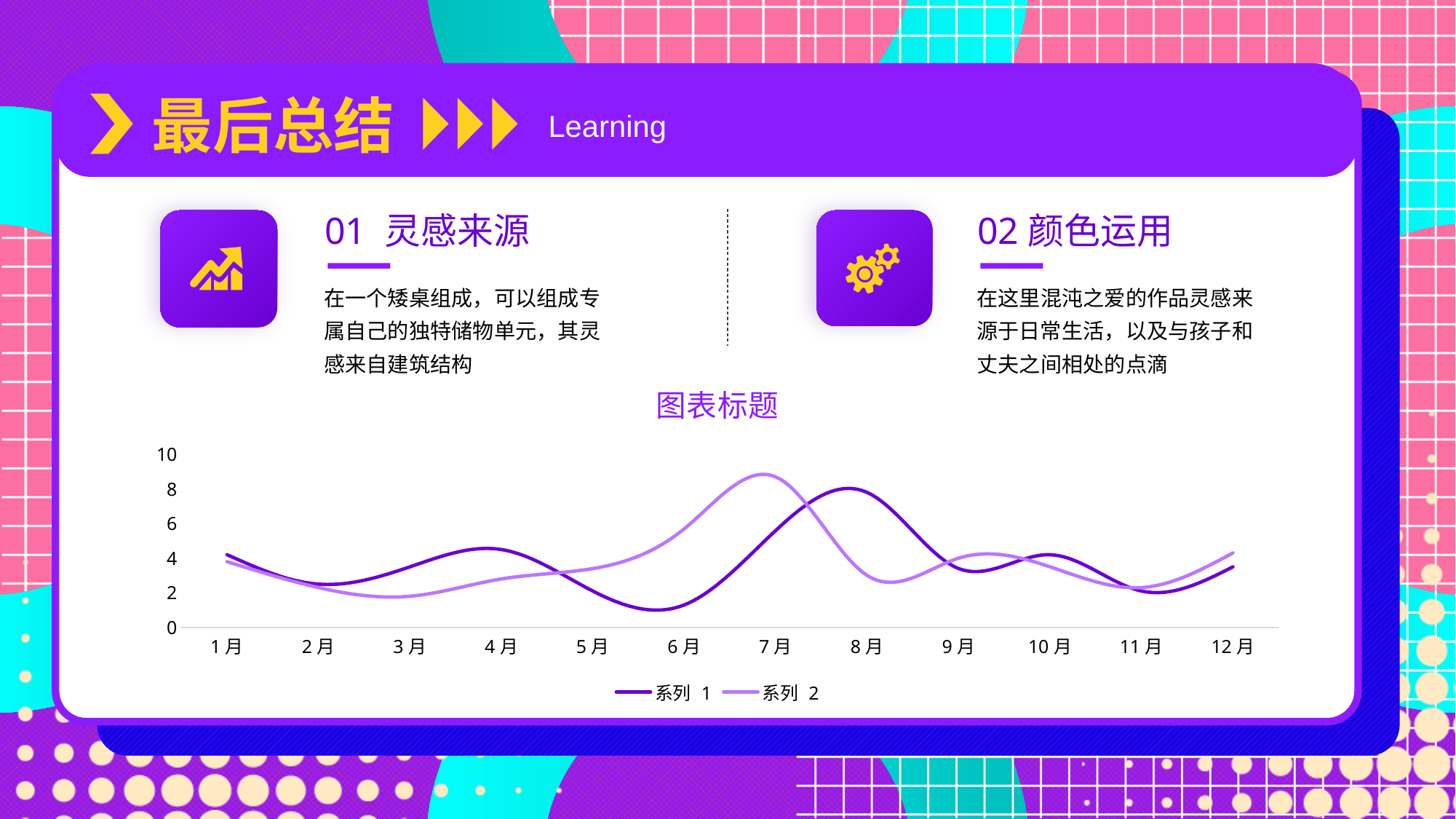
How many months are plotted along the x axis of the chart? 12 In 8月, which series has the larger value, 系列 1 or 系列 2? 系列 1 What are the names of the two series in the chart legend? 系列 1 and 系列 2 Is the value of 系列 2 in 7月 greater or less than 8? greater In which month does 系列 1 reach its lowest value? 6月 Is the value of 系列 1 in 6月 greater or less than 2? less What is the title of the chart? 图表标题 What kind of chart is shown on the slide? line chart In which month does 系列 1 reach its highest value? 8月 In which month does 系列 2 reach its highest value? 7月 In 7月, which series has the larger value, 系列 1 or 系列 2? 系列 2 How many series does the chart legend list? 2